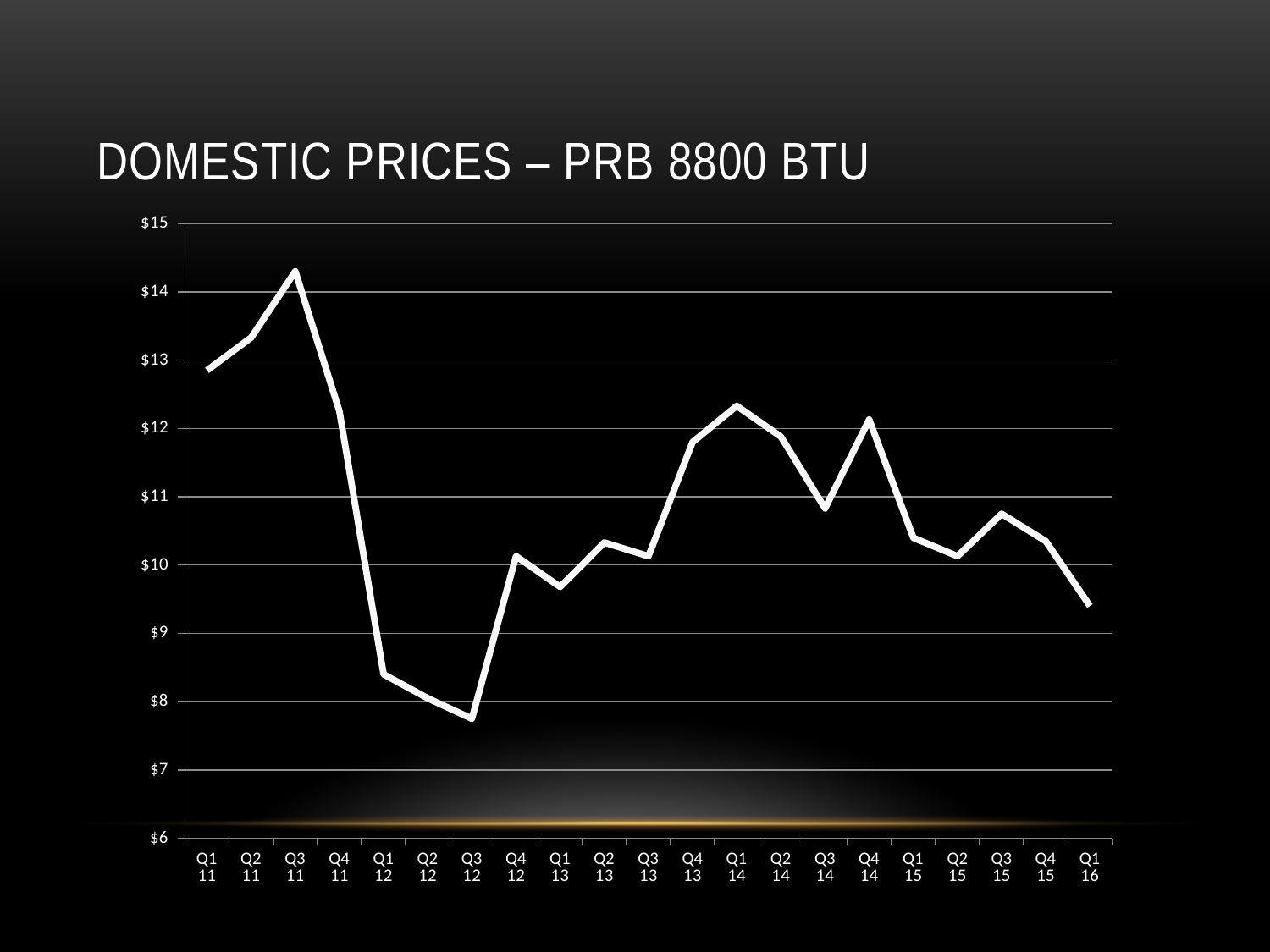
Which quarter has the lowest price? Q3 12 Is the value for Q1 12 greater or less than $9? less Is the value for Q3 11 greater or less than $14? greater Which is higher, the price in Q1 12 or the price in Q1 13? Q1 13 What kind of chart is shown on the slide? line chart Which is higher, the price in Q4 14 or the price in Q1 15? Q4 14 Does the price rise or fall between Q3 11 and Q3 12? fall What is the title of the chart? DOMESTIC PRICES – PRB 8800 BTU How many quarterly data points are plotted on the chart? 21 Is the value for Q1 16 greater or less than $10? less Which quarter has the highest price? Q3 11